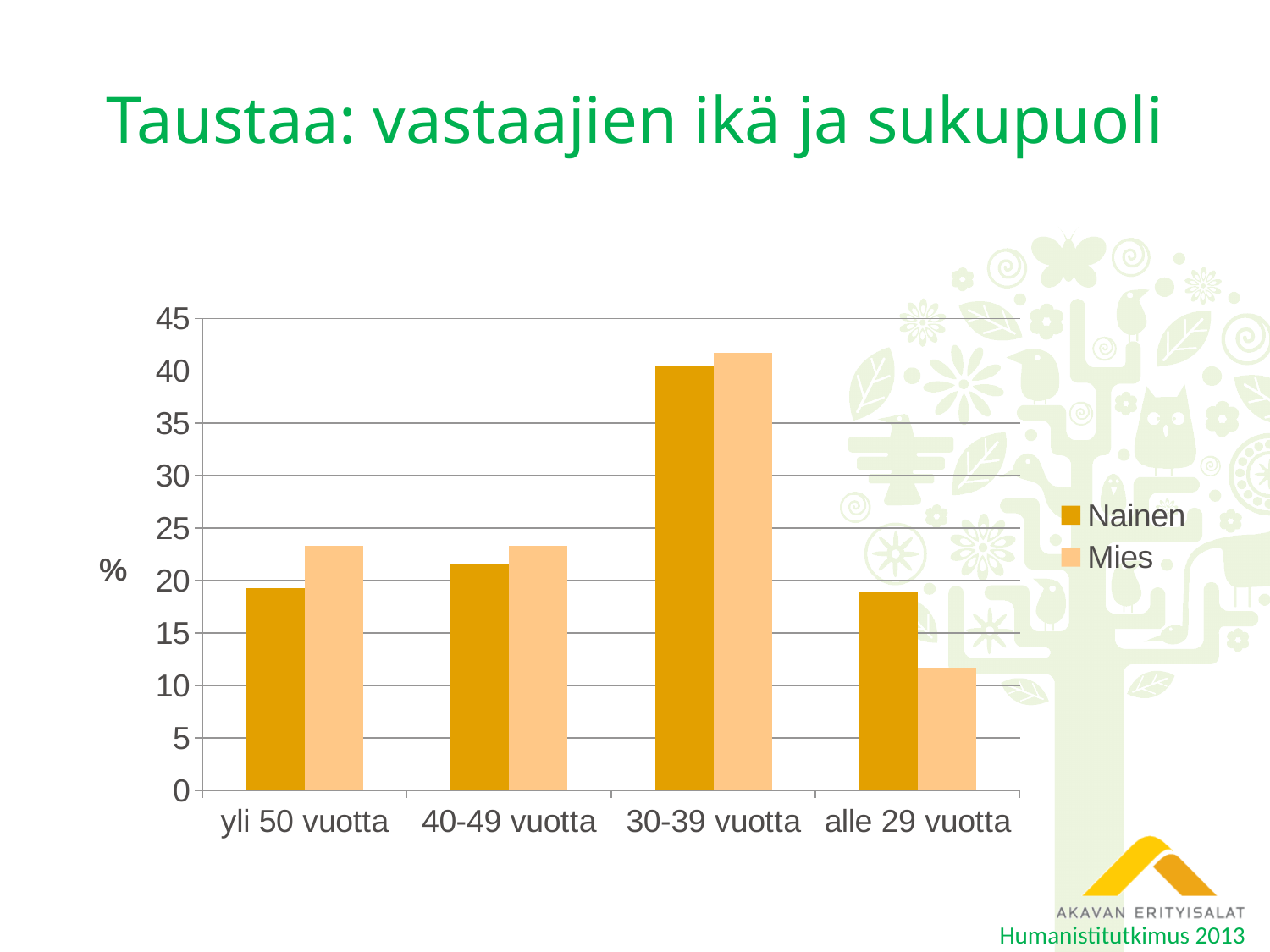
Which age category has the lowest value for Mies? alle 29 vuotta Is the value for Mies in yli 50 vuotta greater or less than 20? greater What kind of chart is shown on the slide? bar chart For yli 50 vuotta, which is larger, Nainen or Mies? Mies How many series does the legend list? 2 How many age categories are shown on the x axis? 4 Which age category has the highest value for Mies? 30-39 vuotta For alle 29 vuotta, which is larger, Nainen or Mies? Nainen What label is shown on the y axis? % Which age category has the highest value for Nainen? 30-39 vuotta Is the value for Nainen in 30-39 vuotta greater or less than 35? greater Is the value for Mies in alle 29 vuotta greater or less than 15? less